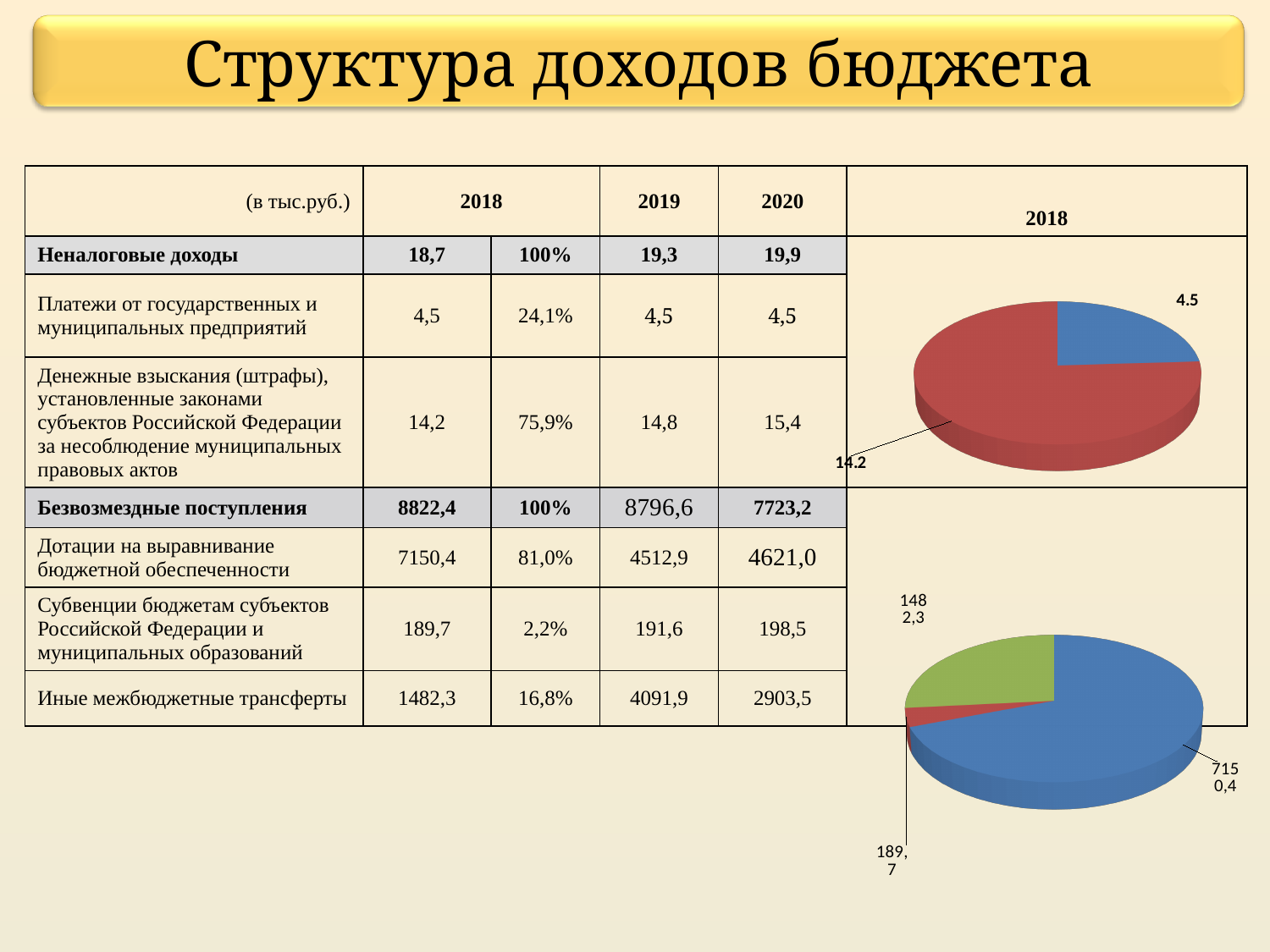
In the pie chart titled "2018", what value is labelled on the blue slice? 4.5 In the lower pie chart on the slide, what value is labelled on the blue slice? 7150,4 In the lower pie chart on the slide, what value is labelled on the red slice? 189,7 In the pie chart titled "2018", what value is labelled on the red slice? 14.2 In the lower pie chart on the slide, what value is labelled on the green slice? 1482,3 In the lower pie chart on the slide, which slice has the smallest value? red (189,7) What kind of chart is the chart titled "2018" on the right of the slide? pie chart In the pie chart titled "2018", how many slices are there? 2 In the lower pie chart on the slide, how many slices are there? 3 In the pie chart titled "2018", which slice is larger, the blue one or the red one? red In the lower pie chart on the slide, what is the total of all three slice values? 8822,4 In the pie chart titled "2018", what is the difference between the red slice value and the blue slice value? 9.7